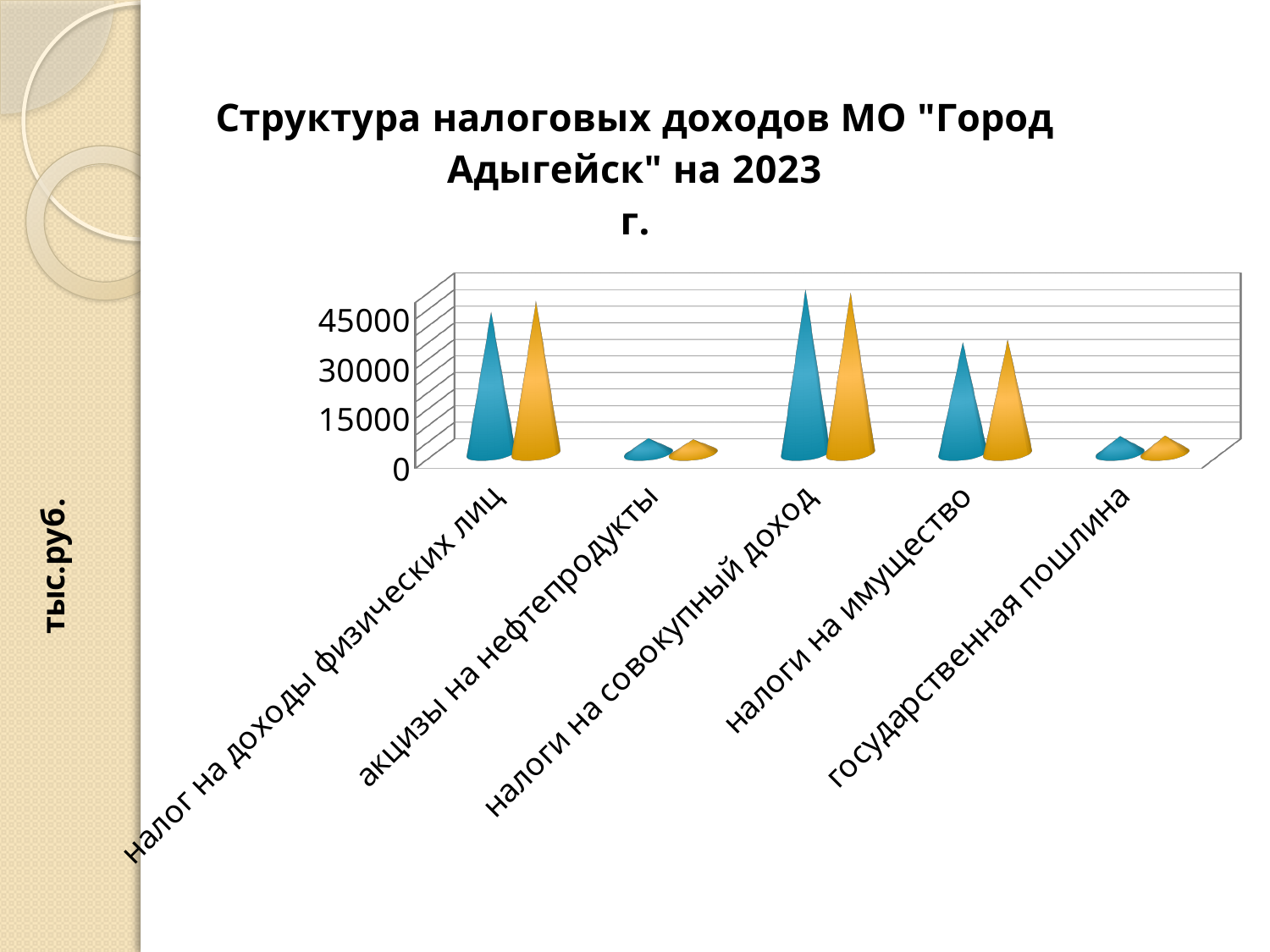
Which category has the highest values in the chart? налоги на совокупный доход Is the value for акцизы на нефтепродукты greater or less than 15000? less Is the value for налоги на имущество greater or less than 15000? greater What unit is indicated for the values on the chart? тыс.руб. Is the value for государственная пошлина greater or less than 15000? less What type of chart is shown on the slide? bar chart Which is larger, the value for налоги на имущество or the value for акцизы на нефтепродукты? налоги на имущество How many categories are shown on the x axis of the chart? 5 What is the title of the chart? Структура налоговых доходов МО "Город Адыгейск" на 2023 г. Which is larger, the value for налоги на совокупный доход or the value for государственная пошлина? налоги на совокупный доход